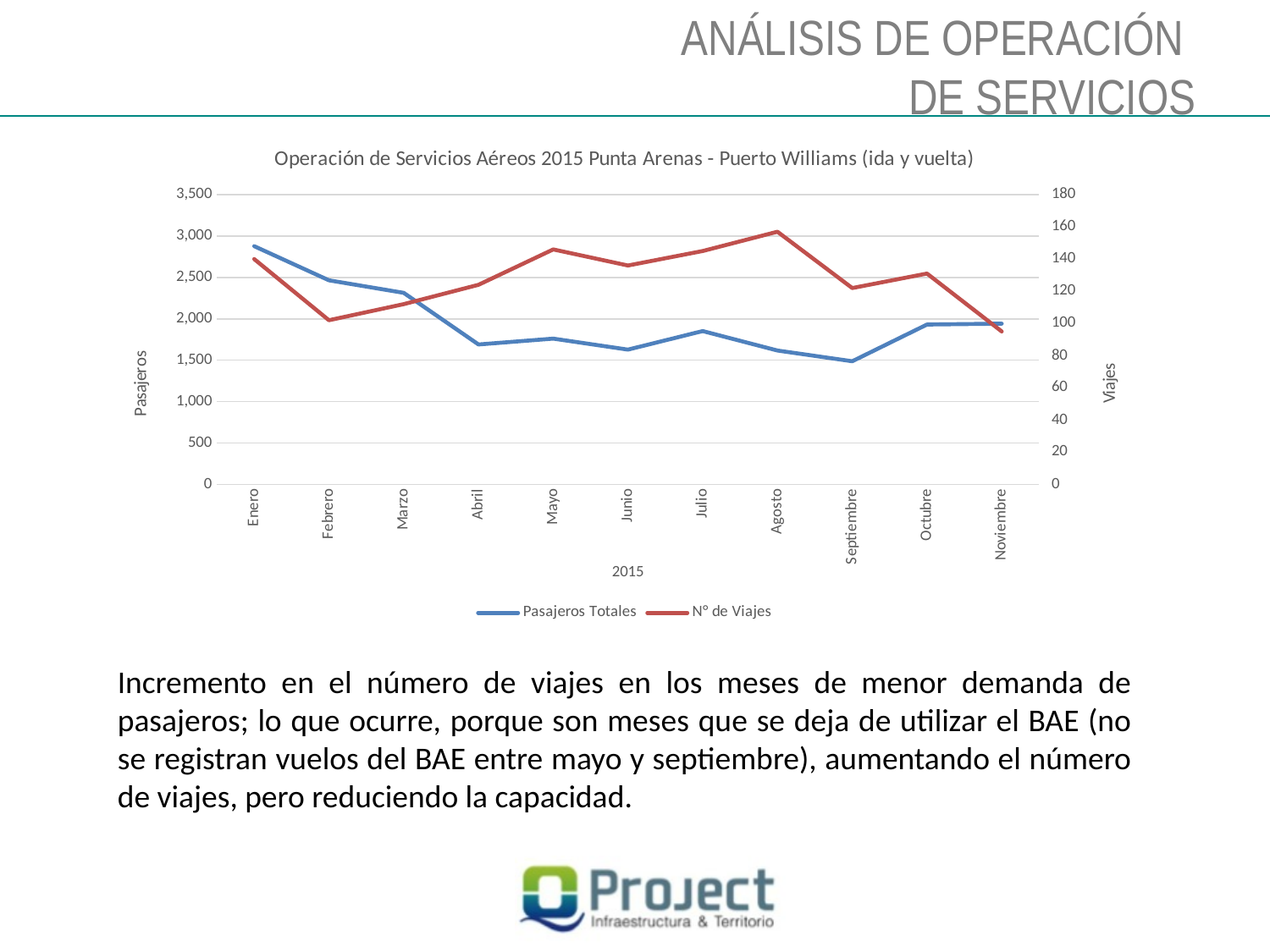
In which month is the Pasajeros Totales value lowest? Septiembre What kind of chart is shown on the slide? line chart In which month is the Pasajeros Totales value highest? Enero How many months are plotted along the x axis? 11 Is the N° de Viajes value for Agosto greater or less than 140? greater Is the Pasajeros Totales value for Enero greater or less than 2,500? greater Which month has more Pasajeros Totales, Enero or Noviembre? Enero What is the title of the chart? Operación de Servicios Aéreos 2015 Punta Arenas - Puerto Williams (ida y vuelta) Is the Pasajeros Totales value for Abril greater or less than 2,000? less In which month is the N° de Viajes value highest? Agosto How many series does the legend list? 2 Does the Pasajeros Totales line rise or fall from Enero to Abril? fall